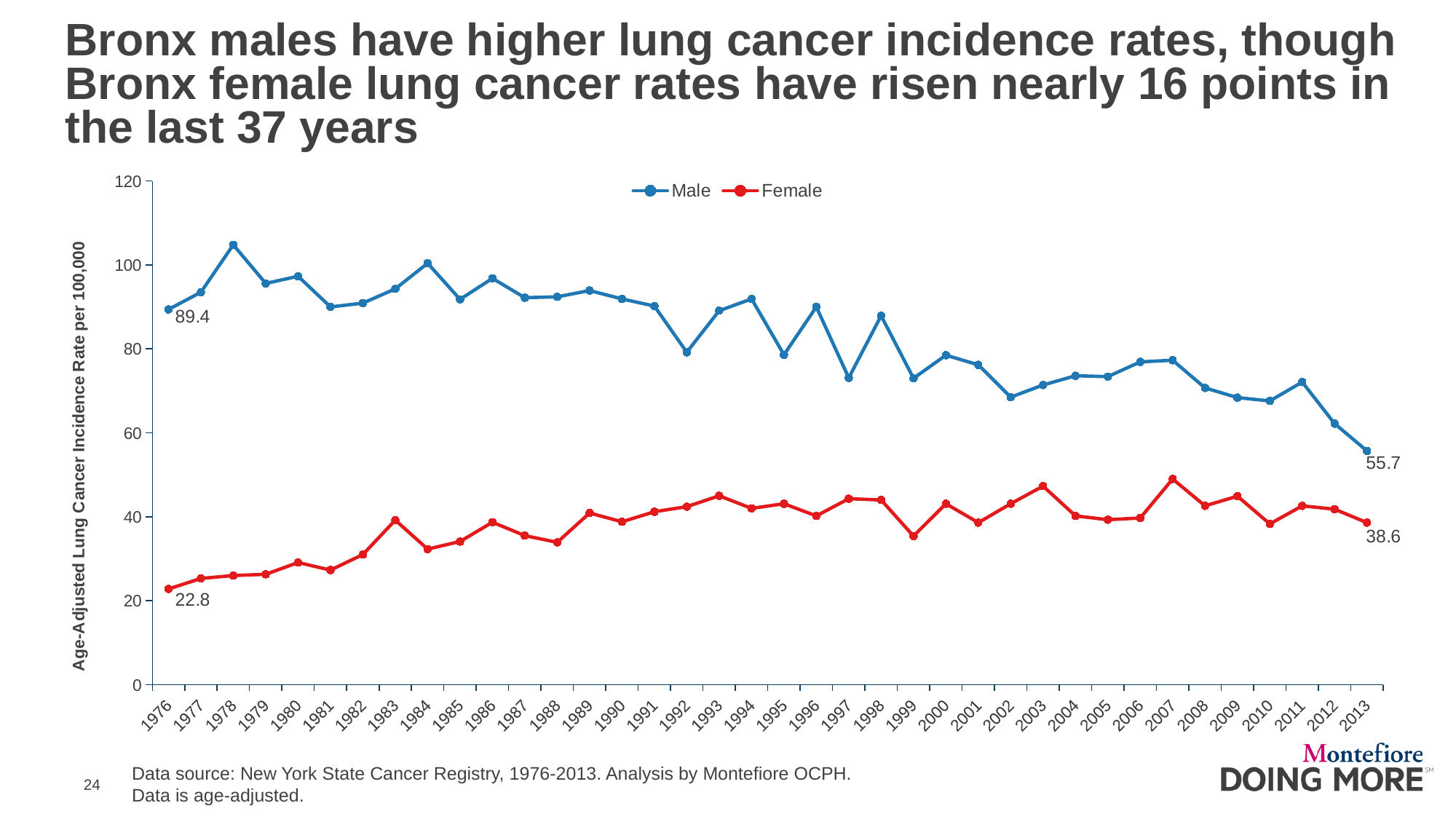
By how much did the female rate increase from 1976 to 2013? 15.8 In which year is the female rate lowest? 1976 What is the female lung cancer incidence rate in 2013? 38.6 What kind of chart is shown on the slide? Line chart What is the difference between the male and female rates in 2013? 17.1 Is the male rate in 1997 greater or less than 80? less What is the female lung cancer incidence rate in 1976? 22.8 How many series does the legend list? 2 What is the male lung cancer incidence rate in 2013? 55.7 In 2013, which series has the higher rate, Male or Female? Male What is the male lung cancer incidence rate in 1976? 89.4 Is the male rate in 1978 greater or less than 100? greater